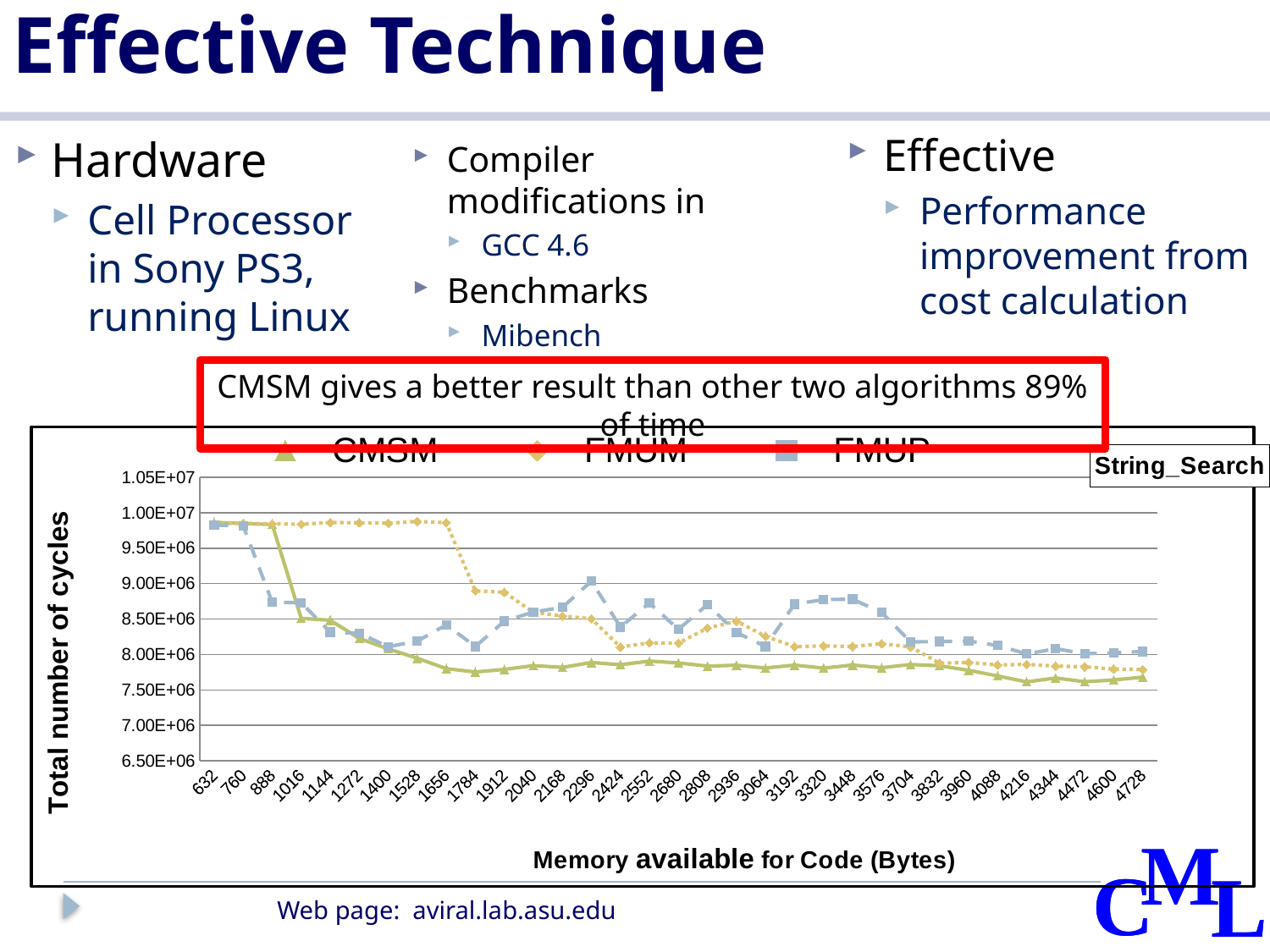
Is the value for FMUM at 1656 bytes greater or less than 9.50E+06? greater What is the title of the y axis of the chart? Total number of cycles Which series are listed in the chart legend? CMSM, FMUM, FMUP Is the value for FMUP at 1016 bytes greater or less than 9.00E+06? less At 1656 bytes, which series has the higher value, FMUM or CMSM? FMUM How many memory sizes are plotted along the x axis of the chart? 33 Does the CMSM series generally rise or fall as memory available increases along the x axis? fall Is the value for CMSM at 4728 bytes greater or less than 8.00E+06? less How many series does the chart legend list? 3 What kind of chart is shown on the slide? line chart Which series has the lowest value at 4728 bytes? CMSM